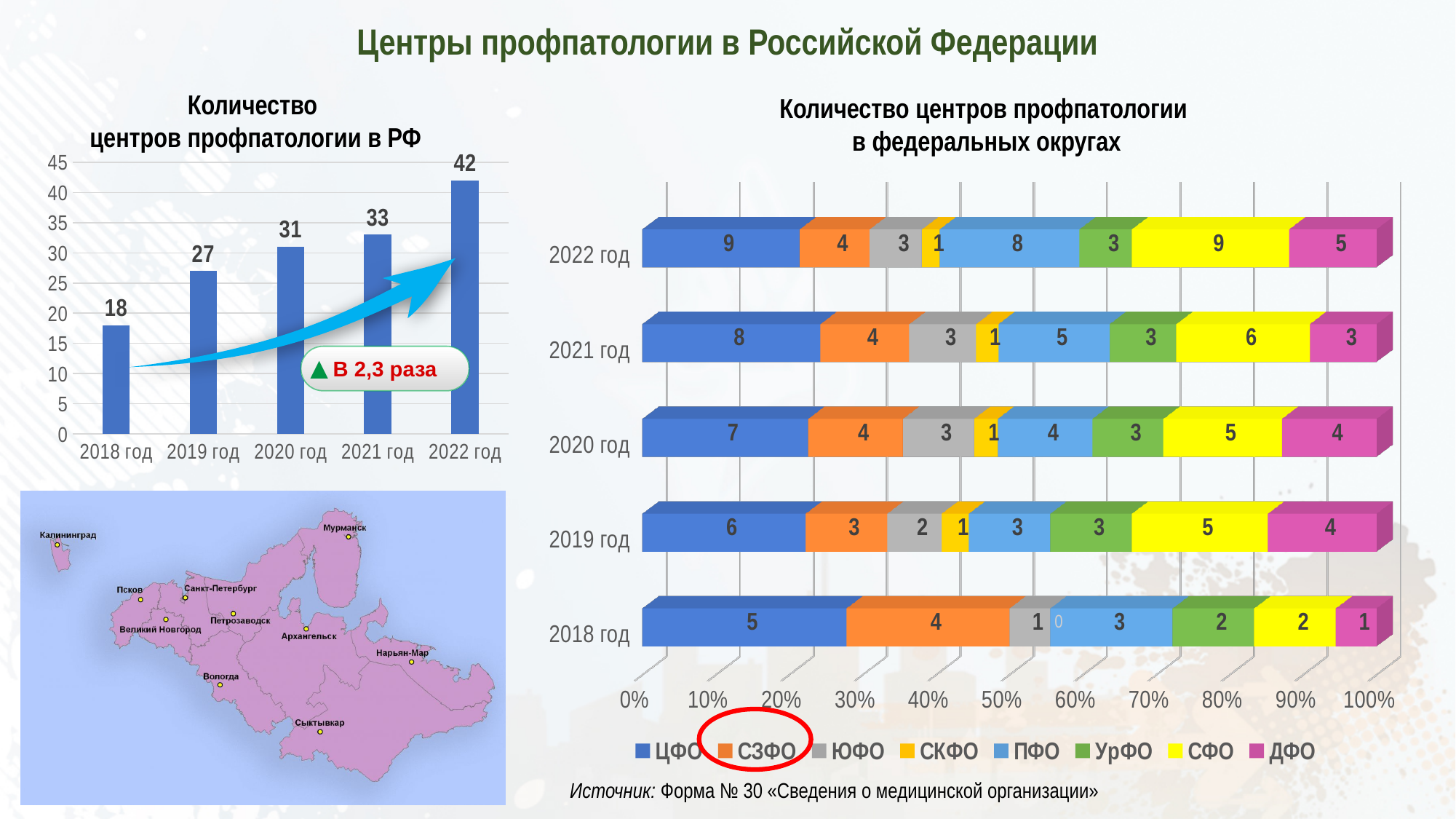
In the chart 'Количество центров профпатологии в РФ', do the values rise or fall from 2018 год to 2022 год? rise In the chart 'Количество центров профпатологии в РФ', how many years are shown on the x axis? 5 In the chart 'Количество центров профпатологии в федеральных округах', which legend entry is circled in red? СЗФО In the chart 'Количество центров профпатологии в федеральных округах', what is the value for ПФО in 2022 год? 8 What kind of chart is 'Количество центров профпатологии в федеральных округах'? stacked bar chart In the chart 'Количество центров профпатологии в федеральных округах', how many series does the legend list? 8 In the chart 'Количество центров профпатологии в РФ', which year has the highest value? 2022 год In the chart 'Количество центров профпатологии в РФ', which year has the lowest value? 2018 год In the chart 'Количество центров профпатологии в РФ', what is the difference between the values for 2022 год and 2018 год? 24 In the chart 'Количество центров профпатологии в РФ', what is the value for 2020 год? 31 In the chart 'Количество центров профпатологии в федеральных округах', what is the value for СКФО in 2018 год? 0 In the chart 'Количество центров профпатологии в федеральных округах', what is the total of the stacked bar for 2021 год? 33